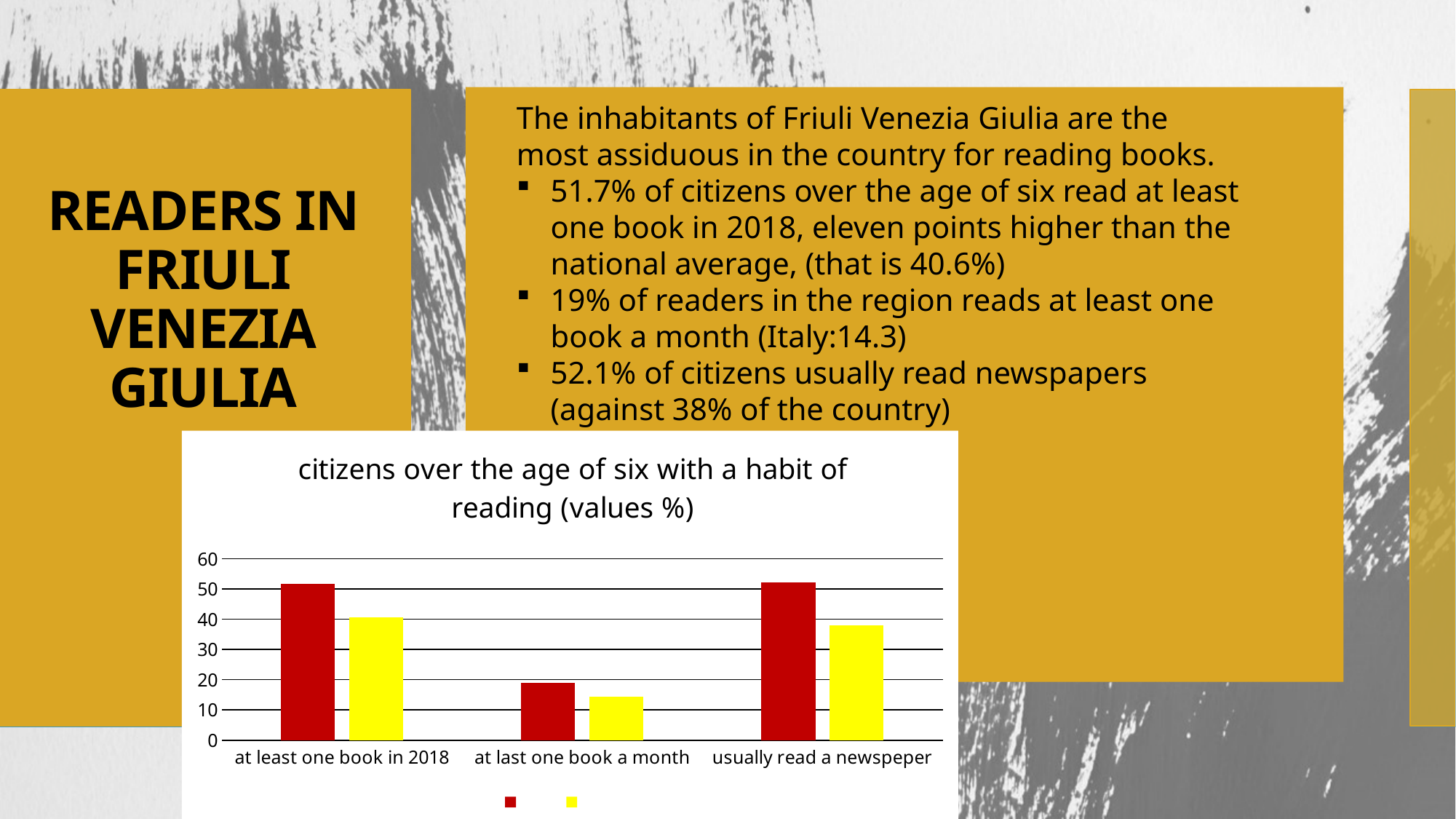
Is the yellow bar for 'usually read a newspeper' greater or less than 30? greater Is the red bar for 'at least one book in 2018' greater or less than 40? greater How many categories are shown on the x axis of the chart? 3 What is the title of the chart? citizens over the age of six with a habit of reading (values %) How many series does the chart's legend list? 2 What kind of chart is shown on the slide? bar chart Which category has the lowest red bar? at last one book a month For 'usually read a newspeper', which bar is larger, the red one or the yellow one? red Is the yellow bar for 'at last one book a month' greater or less than 20? less Which category has the lowest yellow bar? at last one book a month What two colours are used for the bars in the chart? red and yellow For 'at least one book in 2018', which bar is larger, the red one or the yellow one? red